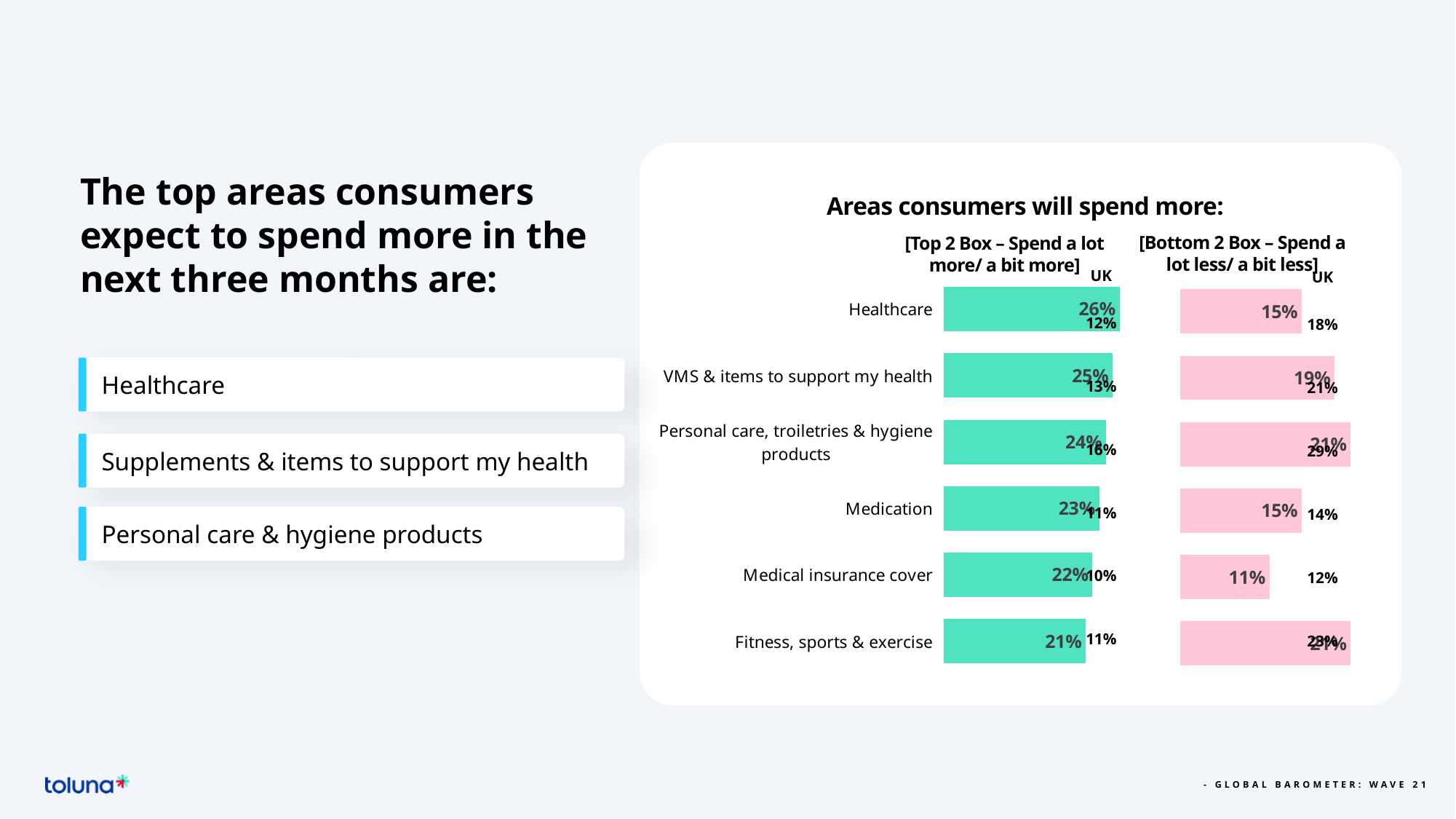
In the Bottom 2 Box (Spend a lot less/ a bit less) chart, what is the value for VMS & items to support my health? 19% In the Top 2 Box (Spend a lot more/ a bit more) chart, which category has the lowest value? Fitness, sports & exercise In the Top 2 Box (Spend a lot more/ a bit more) chart, do the values rise or fall going down the list from Healthcare to Fitness, sports & exercise? fall In the Top 2 Box (Spend a lot more/ a bit more) chart, what is the difference between Healthcare and Medical insurance cover? 4% What kind of chart is used to show the Top 2 Box (Spend a lot more/ a bit more) data? bar chart In the Top 2 Box (Spend a lot more/ a bit more) chart, how many categories are shown? 6 In the Top 2 Box (Spend a lot more/ a bit more) chart, what is the value for Healthcare? 26% In the Top 2 Box (Spend a lot more/ a bit more) chart, what is the value for Medication? 23% In the Top 2 Box (Spend a lot more/ a bit more) chart, what is the value for Fitness, sports & exercise? 21% In the Bottom 2 Box (Spend a lot less/ a bit less) chart, which category has the lowest value? Medical insurance cover In the Bottom 2 Box (Spend a lot less/ a bit less) chart, what is the value for Medical insurance cover? 11% In the Top 2 Box (Spend a lot more/ a bit more) chart, which category has the highest value? Healthcare